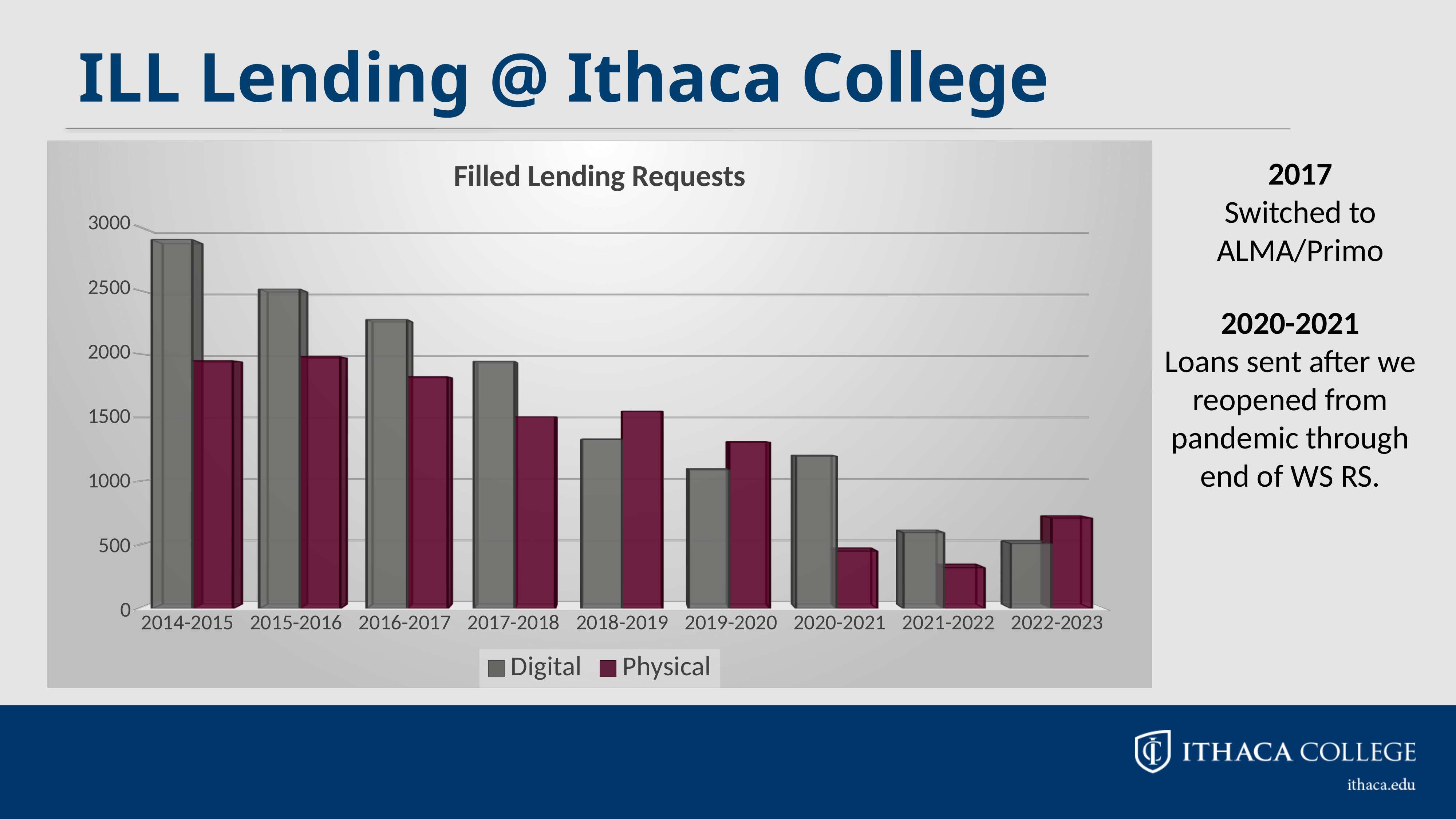
How many series does the legend list? 2 In which year is the Physical value lowest? 2021-2022 What kind of chart is shown on the slide? Bar chart Do the Digital values generally rise or fall from 2014-2015 to 2022-2023? fall In 2014-2015, which is larger, Digital or Physical? Digital Is the Digital value for 2014-2015 greater or less than 2500? greater Is the Physical value for 2021-2022 greater or less than 500? less In which year is the Digital value highest? 2014-2015 How many academic years are shown on the x axis? 9 Is the Digital value for 2016-2017 greater or less than 2000? greater In 2018-2019, which is larger, Digital or Physical? Physical What is the title of the chart? Filled Lending Requests